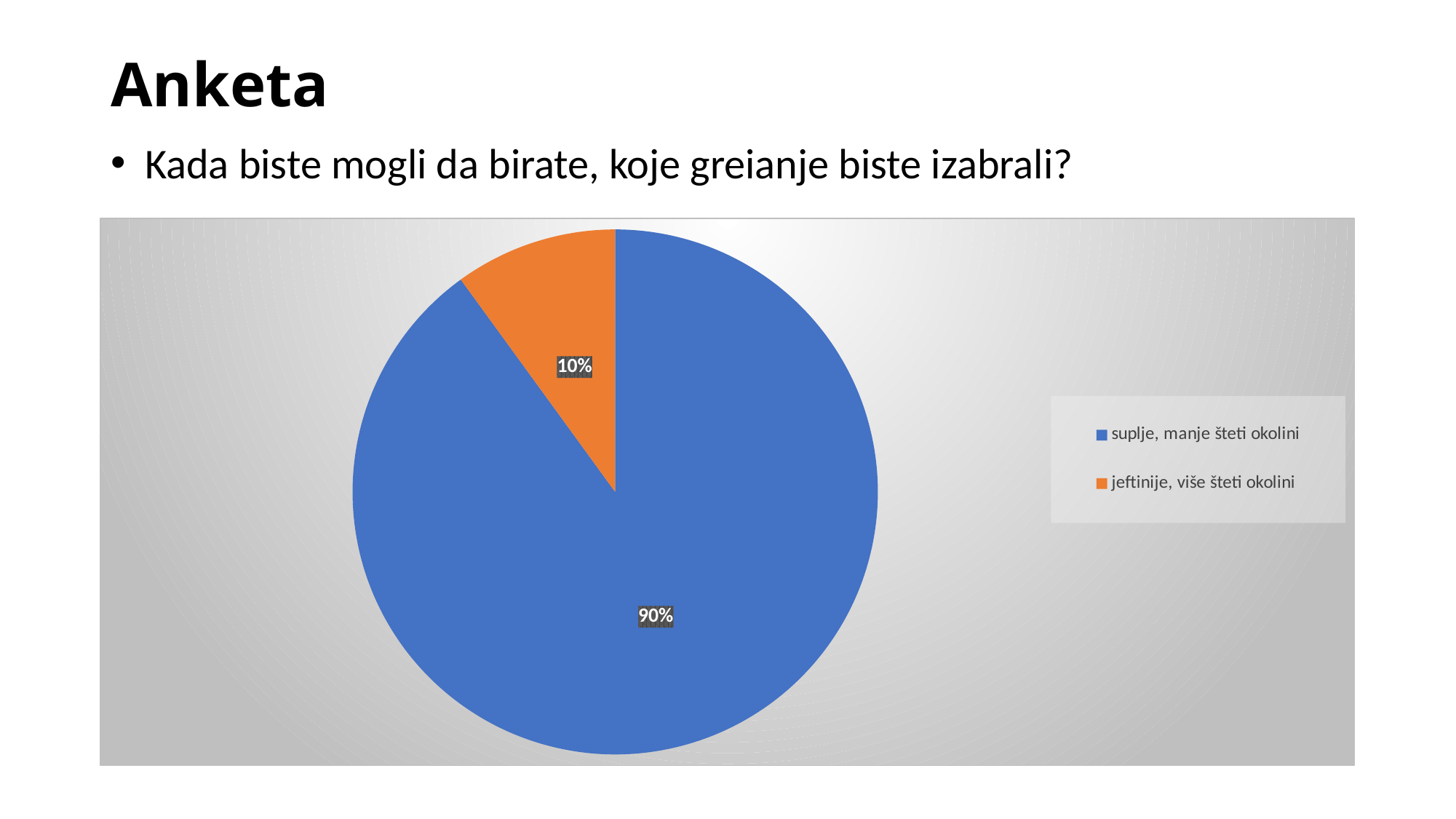
Which category has the smallest slice of the pie? jeftinije, više šteti okolini How many entries does the legend list? 2 What is the difference in percentage points between the "suplje, manje šteti okolini" slice and the "jeftinije, više šteti okolini" slice? 80 percentage points Which is larger: the slice for "suplje, manje šteti okolini" or the slice for "jeftinije, više šteti okolini"? suplje, manje šteti okolini Which category has the largest slice of the pie? suplje, manje šteti okolini What share of the pie does "suplje, manje šteti okolini" have? 90% What colour is the slice for "jeftinije, više šteti okolini"? orange What share of the pie does "jeftinije, više šteti okolini" have? 10% How many slices does the pie chart have? 2 What kind of chart is shown on the slide? pie chart What colour is the slice for "suplje, manje šteti okolini"? blue